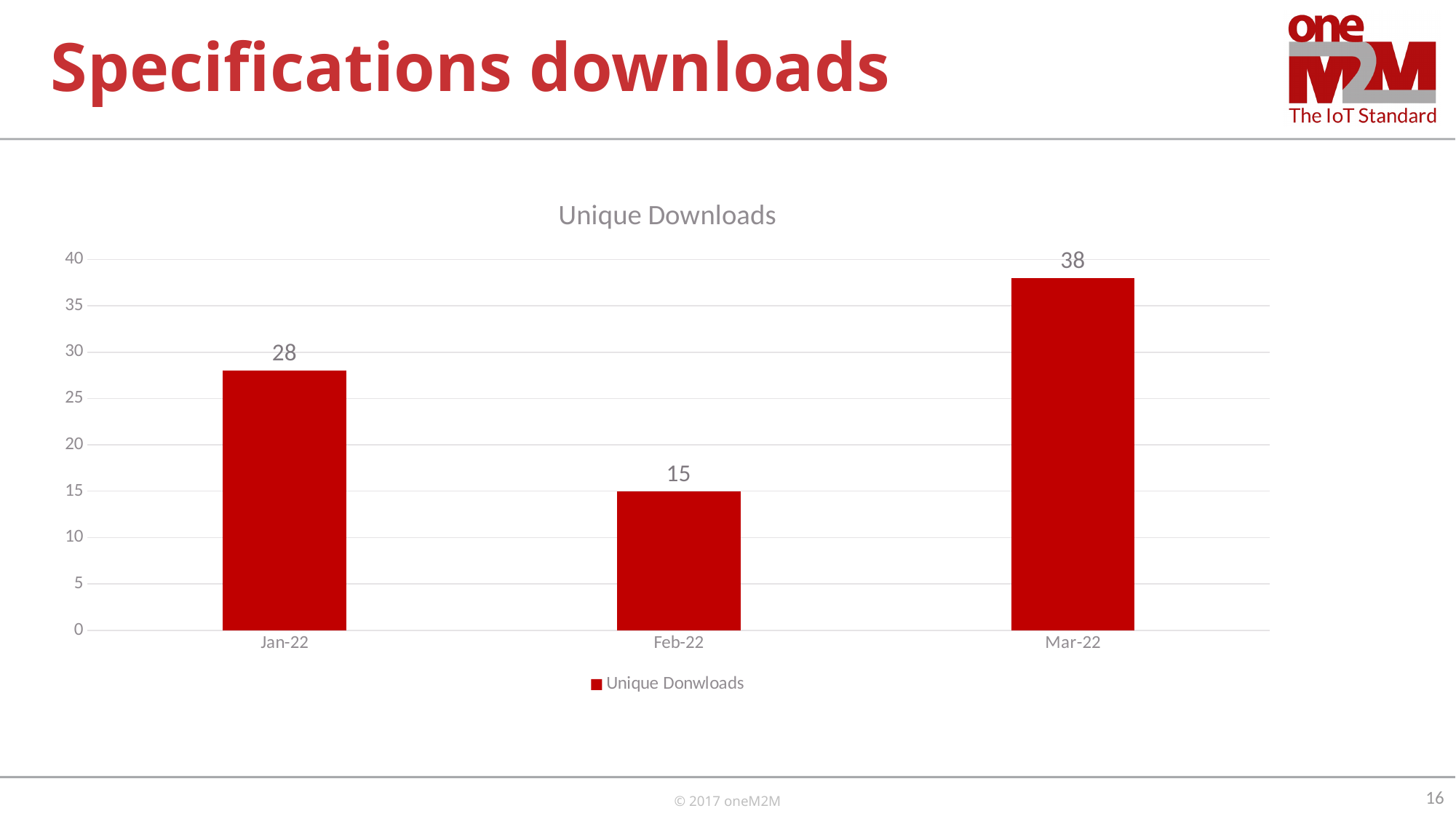
What is the value for Jan-22? 28 What is the difference between the values for Jan-22 and Feb-22? 13 What is the difference between the values for Mar-22 and Feb-22? 23 Which month has the highest number of unique downloads? Mar-22 Which month has the lowest number of unique downloads? Feb-22 How many months are shown on the x axis? 3 Which is larger, the value for Jan-22 or the value for Mar-22? Mar-22 What kind of chart is shown on the slide? bar chart Is the value for Feb-22 greater or less than 20? less What is the value for Mar-22? 38 What is the title of the chart? Unique Downloads What is the value for Feb-22? 15